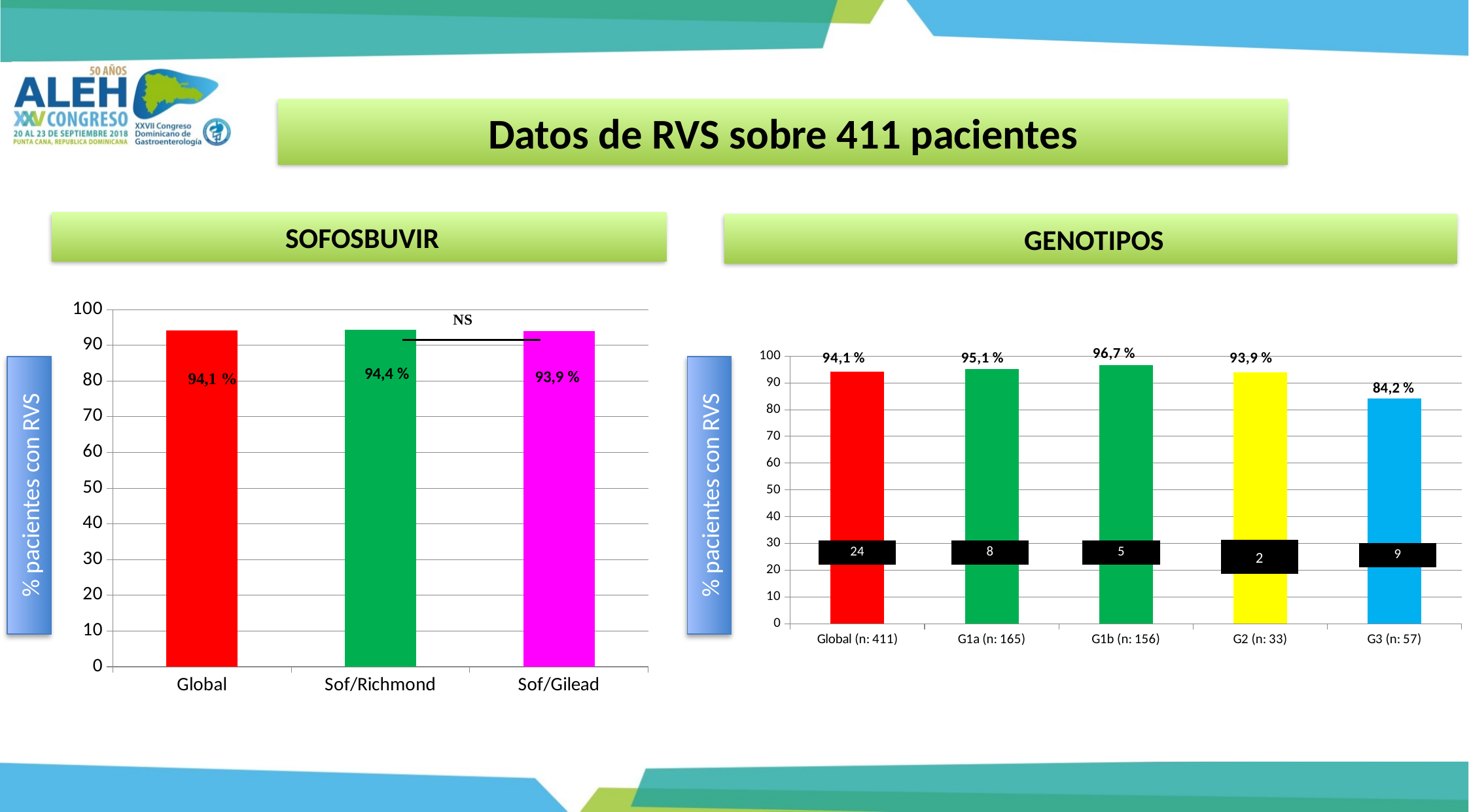
In the SOFOSBUVIR chart, what is the difference between the Sof/Richmond and Sof/Gilead values? 0,5 % In the GENOTIPOS chart, which category has the highest value? G1b (n: 156) In the GENOTIPOS chart, which category has the lowest value? G3 (n: 57) In the SOFOSBUVIR chart, how many categories are shown on the x axis? 3 In the GENOTIPOS chart, how many categories are shown on the x axis? 5 In the SOFOSBUVIR chart, what is the value for Sof/Richmond? 94,4 % In the GENOTIPOS chart, what is the value for G3 (n: 57)? 84,2 % In the GENOTIPOS chart, what is the difference between the G1b (n: 156) and G3 (n: 57) values? 12,5 % In the GENOTIPOS chart, what is the value for G1b (n: 156)? 96,7 % In the GENOTIPOS chart, what is the y-axis label? % pacientes con RVS In the SOFOSBUVIR chart, what is the value for Sof/Gilead? 93,9 % What kind of chart is the SOFOSBUVIR chart? bar chart